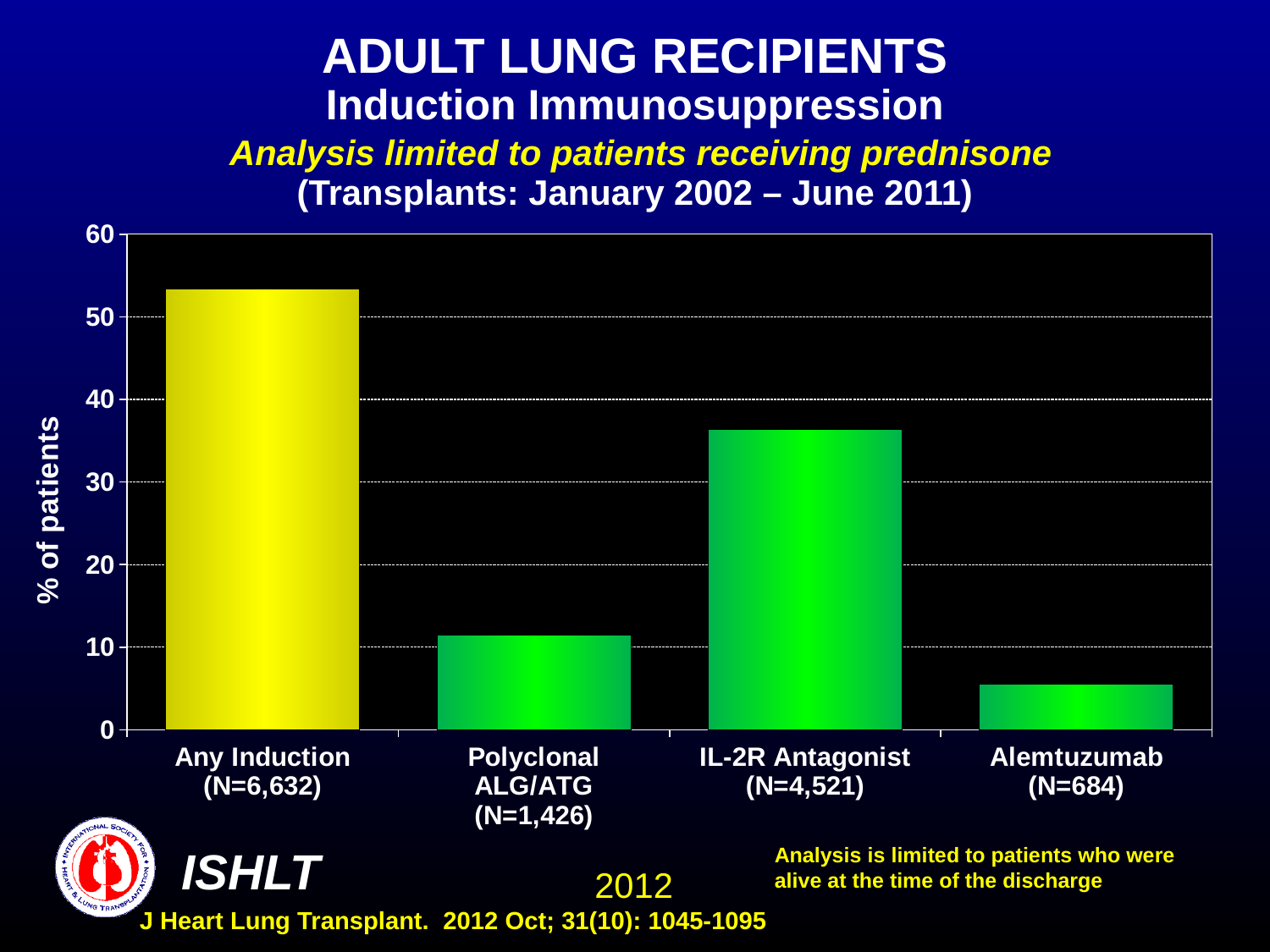
What is the label of the y axis? % of patients What kind of chart is shown on the slide? bar chart Is the value for Any Induction greater or less than 50? greater How many categories are plotted on the x axis? 4 Which category has the lowest percentage of patients? Alemtuzumab Is the value for Polyclonal ALG/ATG greater or less than 20? less Which is larger, the value for Polyclonal ALG/ATG or the value for IL-2R Antagonist? IL-2R Antagonist Is the value for Alemtuzumab greater or less than 10? less What is the N shown for the IL-2R Antagonist category? N=4,521 Which category has the highest percentage of patients? Any Induction